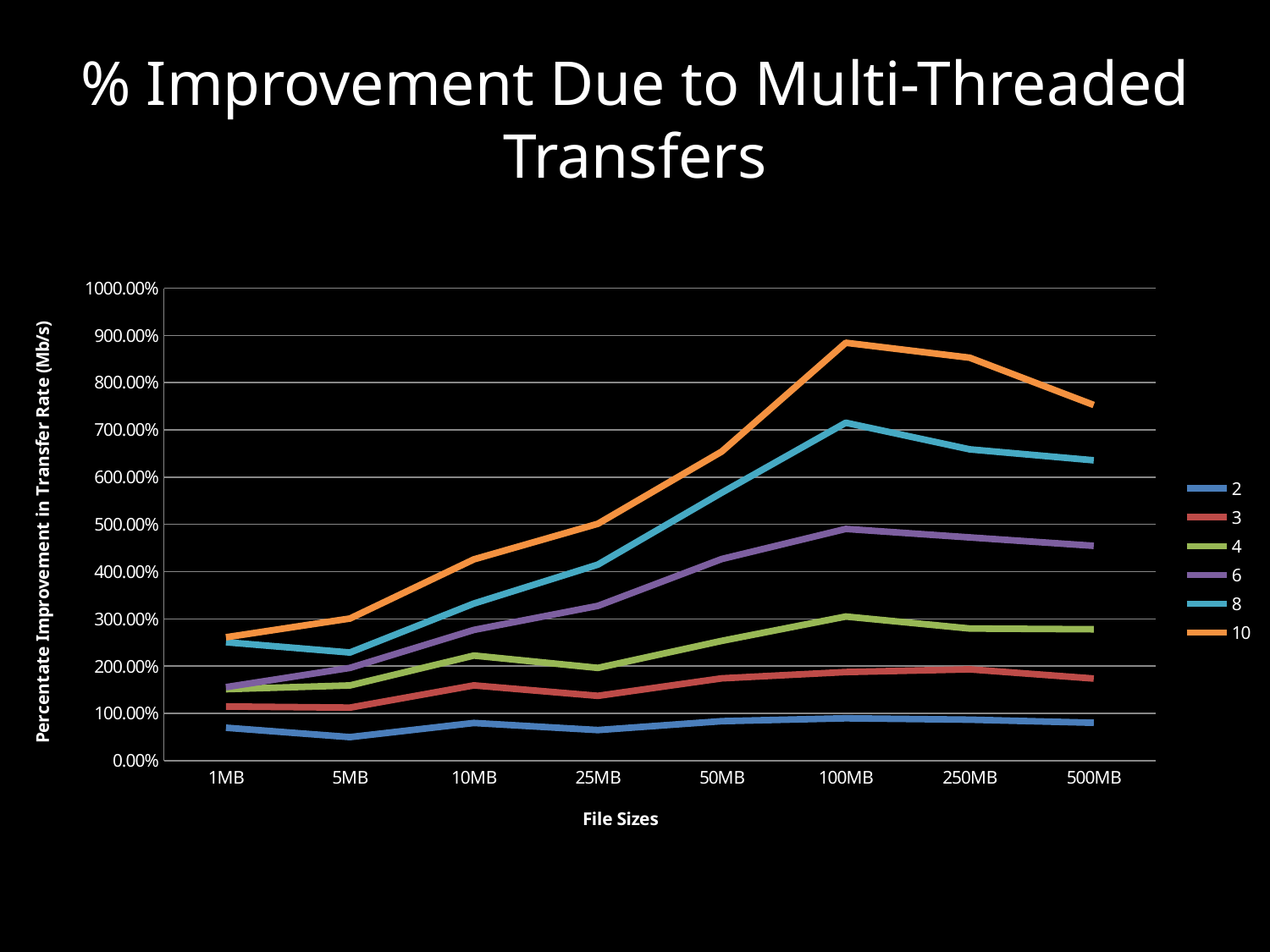
Is the value for series 2 at 5MB greater or less than 100.00%? less At 250MB, which series has the larger value, 4 or 6? 6 How many file size categories are shown on the x axis? 8 What kind of chart is shown on the slide? line chart What is the label of the x axis? File Sizes Is the value for series 6 at 25MB greater or less than 300.00%? greater Is the value for series 10 at 100MB greater or less than 800.00%? greater Does the value for series 10 rise or fall from 100MB to 500MB? fall Which series reaches the highest value at 100MB? 10 How many series does the legend list? 6 Which series has the lowest values across the file sizes? 2